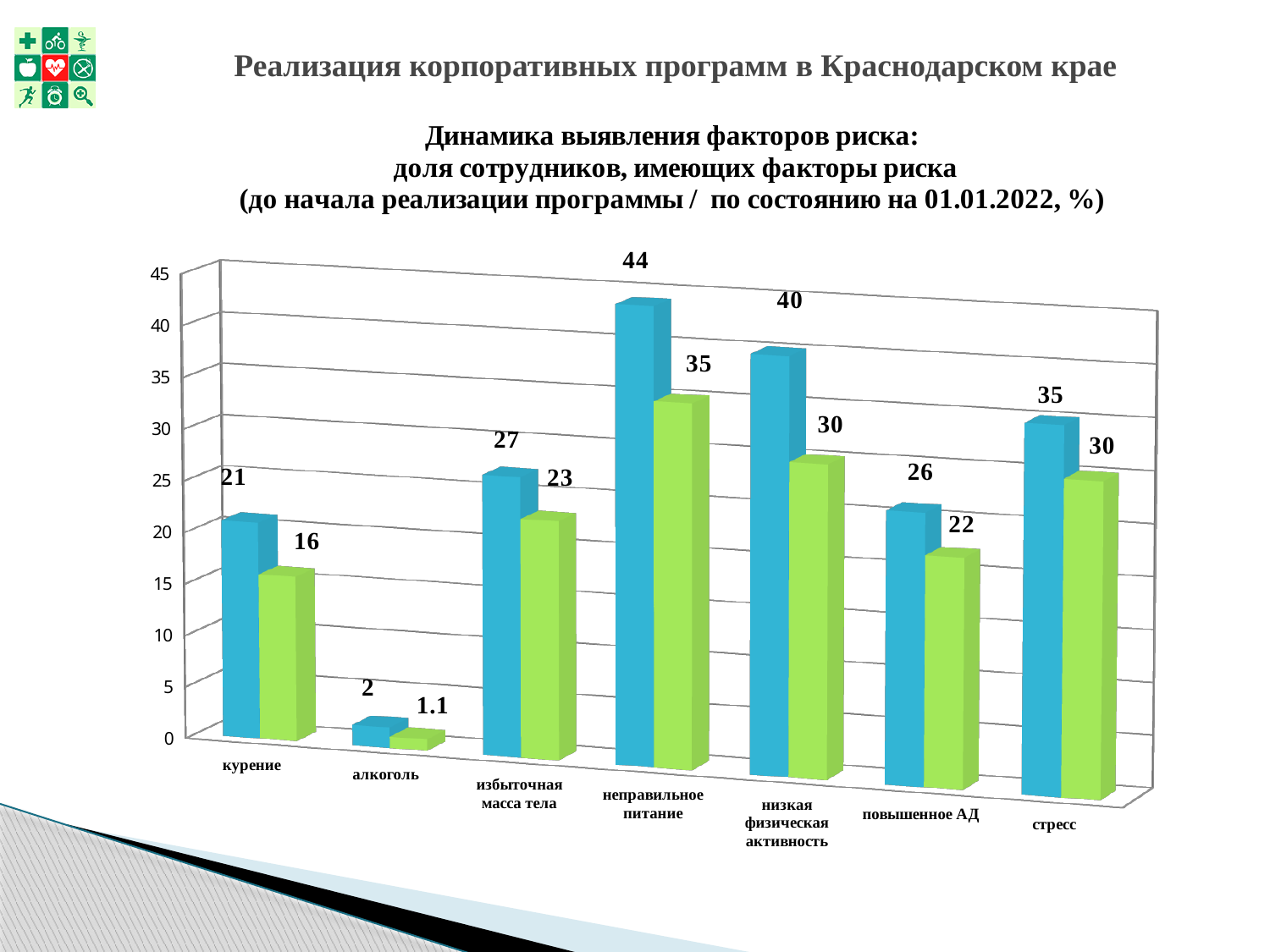
What is the value of the green bar for алкоголь? 1.1 What is the difference between the blue and green bars for неправильное питание? 9 What is the value of the blue bar for курение? 21 How many categories are shown on the x axis? 7 What is the value of the blue bar for повышенное АД? 26 What is the value of the green bar for низкая физическая активность? 30 Which category has the lowest green bar? алкоголь What is the difference between the blue and green bars for избыточная масса тела? 4 What is the maximum value shown on the vertical axis? 45 Which is larger: the blue bar for стресс or the blue bar for низкая физическая активность? низкая физическая активность What type of chart is shown on the slide? bar chart Which category has the highest blue bar? неправильное питание